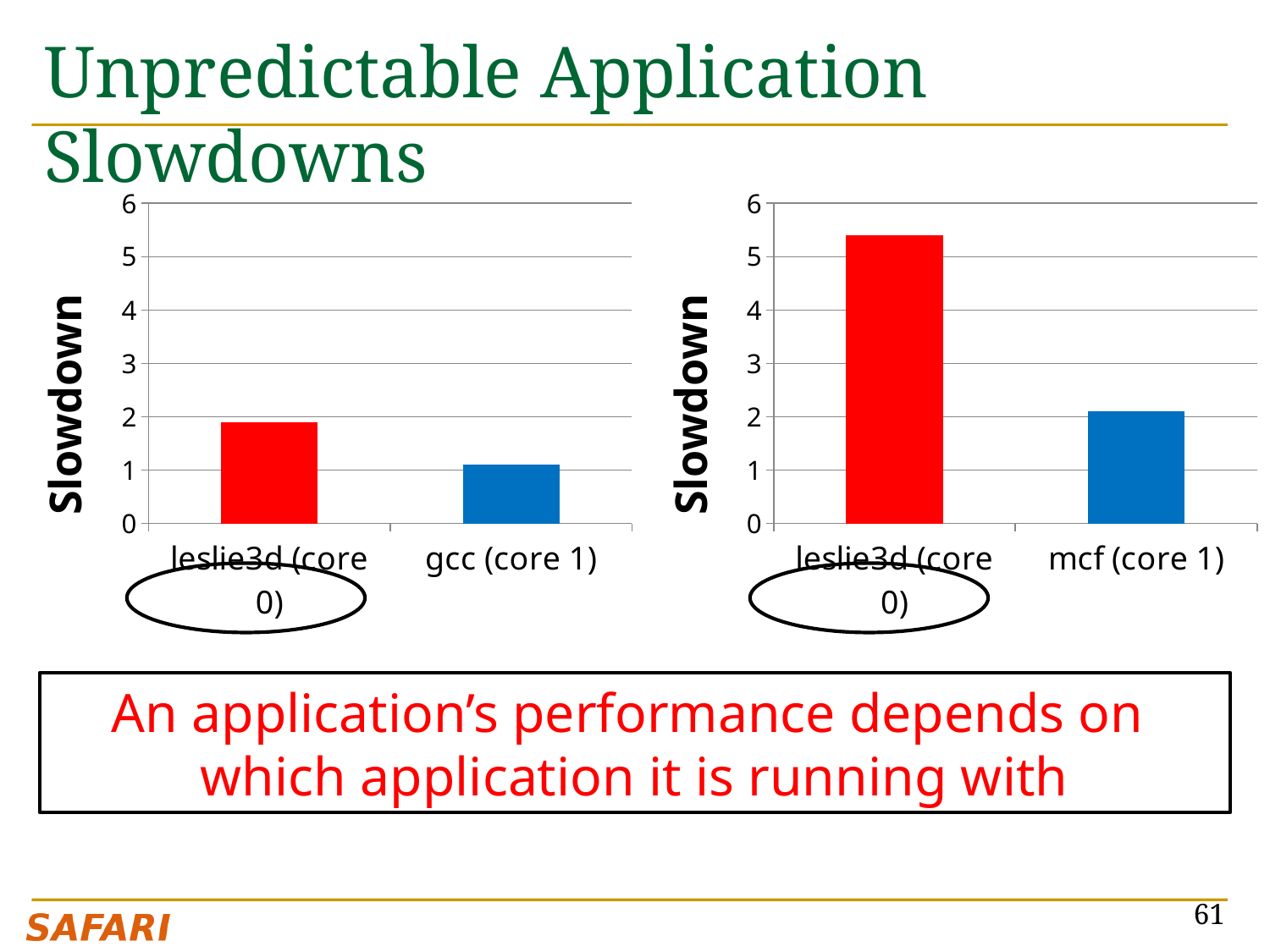
In the left chart, which category has the higher slowdown? leslie3d (core 0) What kind of chart is the left chart on the slide? bar chart In the left chart, is the slowdown for leslie3d (core 0) greater or less than 1? greater In the right chart, which category has the lower slowdown? mcf (core 1) In the right chart, is the slowdown for mcf (core 1) greater or less than 1? greater What is the label of the y axis on the left chart? Slowdown In the right chart, is the slowdown for leslie3d (core 0) greater or less than 5? greater In the right chart, what colour is the bar for leslie3d (core 0)? red How many categories are shown in the right chart? 2 Is the slowdown of leslie3d (core 0) larger in the left chart or in the right chart? right chart